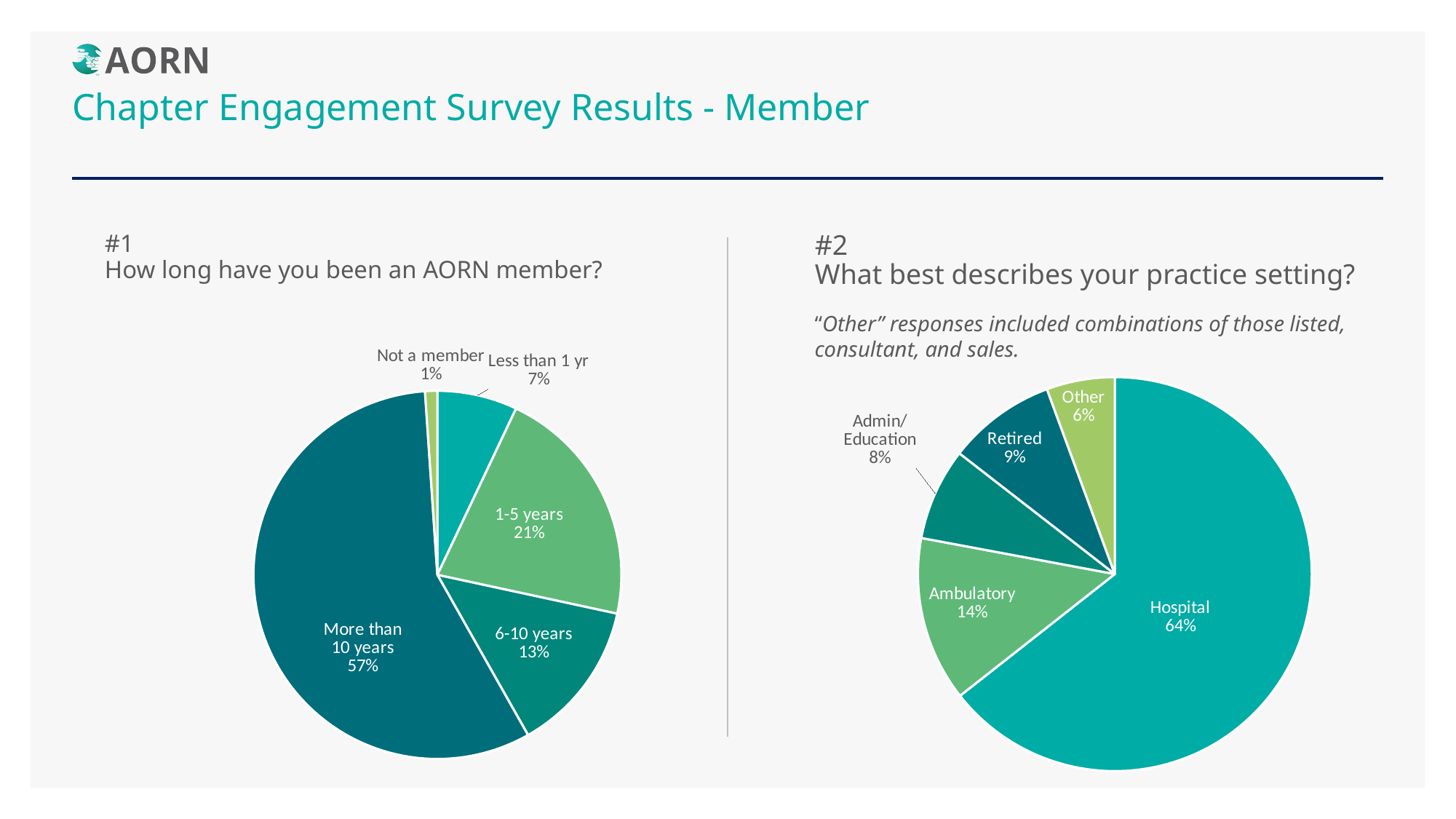
In the left pie chart (How long have you been an AORN member?), which is larger: Less than 1 yr or 6-10 years? 6-10 years In the right pie chart (What best describes your practice setting?), what percentage of respondents work in a hospital setting? 64% What type of chart is used for both survey questions on the slide? Pie chart In the right pie chart (What best describes your practice setting?), what is the difference in percentage points between Ambulatory and Admin/Education? 6 In the right pie chart (What best describes your practice setting?), which practice setting has the largest share? Hospital In the left pie chart (How long have you been an AORN member?), what share of respondents have been members for more than 10 years? 57% In the left pie chart (How long have you been an AORN member?), which category has the smallest share? Not a member In the left pie chart (How long have you been an AORN member?), how many slices does the pie have? 5 In the right pie chart (What best describes your practice setting?), which category has the smallest share? Other In the left pie chart (How long have you been an AORN member?), what is the difference in percentage points between the 1-5 years slice and the 6-10 years slice? 8 In the left pie chart (How long have you been an AORN member?), what percentage of respondents have been members for 1-5 years? 21% In the right pie chart (What best describes your practice setting?), what share of respondents are retired? 9%